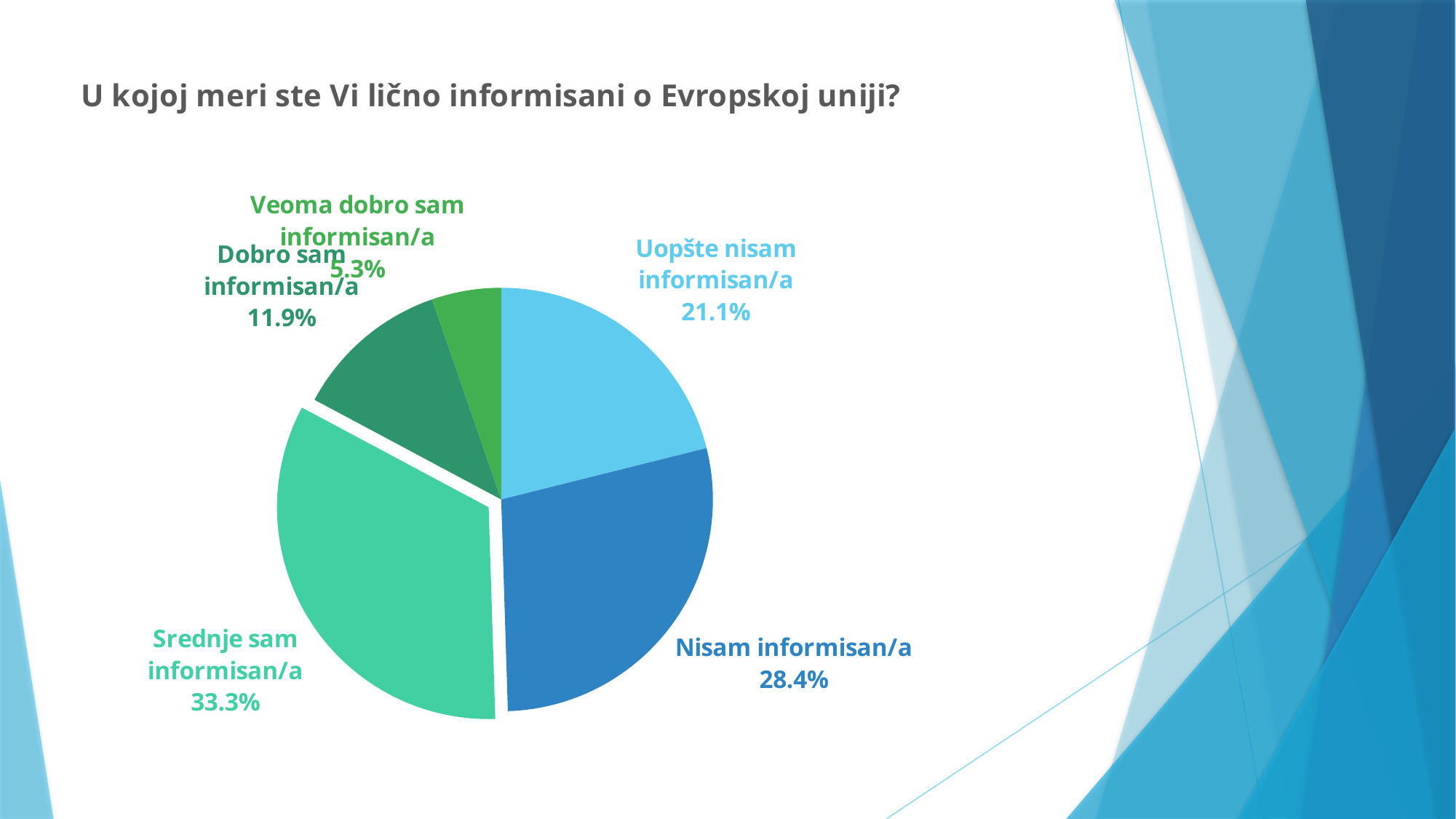
What is the title of the slide? U kojoj meri ste Vi lično informisani o Evropskoj uniji? How many slices does the pie chart have? 5 What percentage is shown for "Nisam informisan/a"? 28.4% Which is larger, the share for "Dobro sam informisan/a" or the share for "Uopšte nisam informisan/a"? Uopšte nisam informisan/a What value is shown for "Uopšte nisam informisan/a"? 21.1% Which category has the largest slice of the pie? Srednje sam informisan/a What is the difference in percentage points between "Srednje sam informisan/a" and "Nisam informisan/a"? 4.9 What is the combined share of "Dobro sam informisan/a" and "Veoma dobro sam informisan/a"? 17.2% Which category has the smallest slice of the pie? Veoma dobro sam informisan/a What percentage is shown for "Veoma dobro sam informisan/a"? 5.3% What type of chart is shown on the slide? Pie chart What share of the pie is labelled "Srednje sam informisan/a"? 33.3%